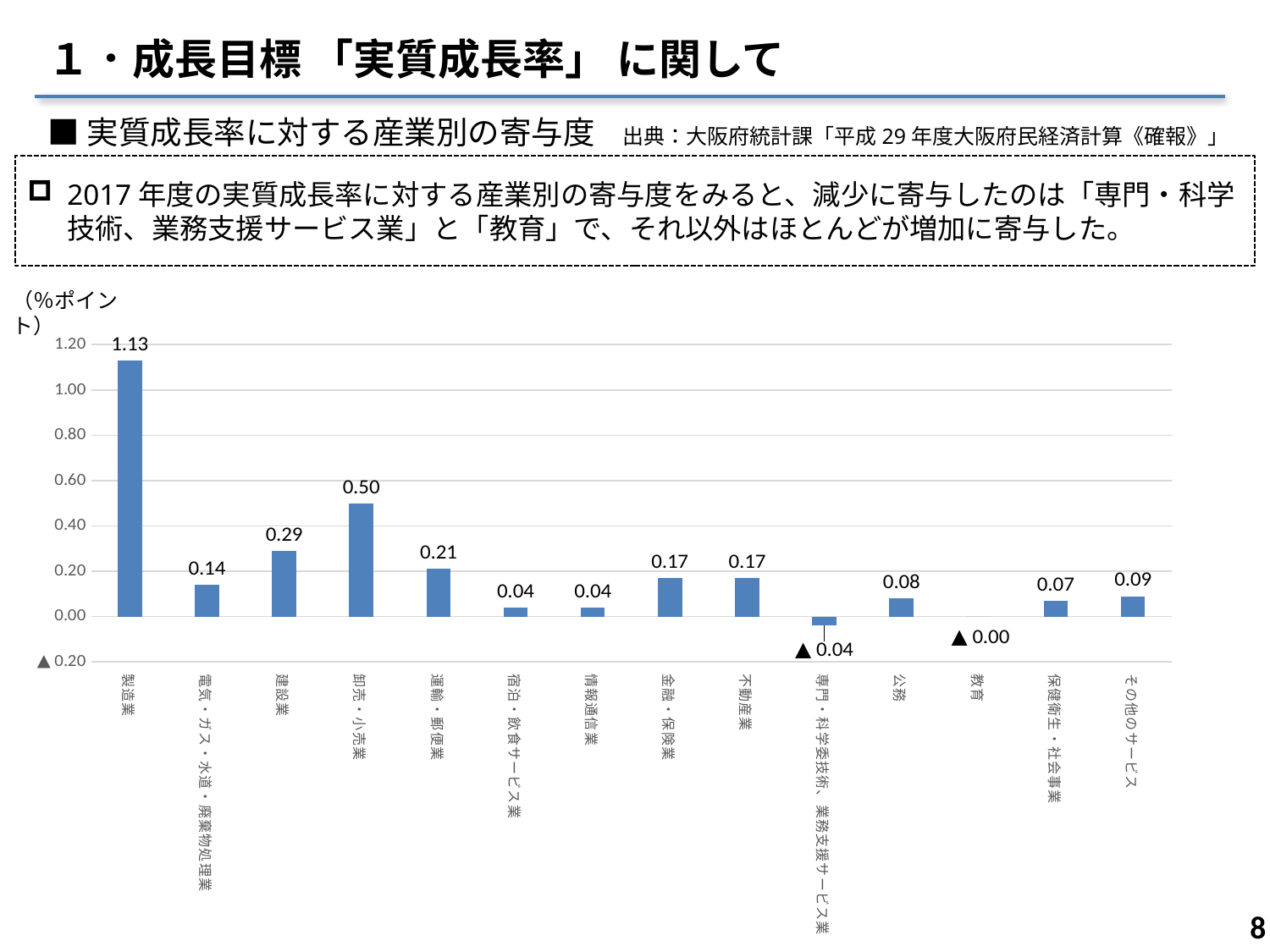
Which is larger, the value for 建設業 or the value for 運輸・郵便業? 建設業 What is the difference between the values for 公務 and その他のサービス? 0.01 What unit is shown above the vertical axis of the chart? %ポイント What kind of chart is shown on the slide? bar chart What is the value for 専門・科学委技術、業務支援サービス業? ▲ 0.04 What is the value for 保健衛生・社会事業? 0.07 What is the value for 卸売・小売業? 0.50 How many categories are shown on the x axis? 14 What is the value for 製造業? 1.13 What is the difference between the values for 製造業 and 卸売・小売業? 0.63 Which category has the lowest value? 専門・科学委技術、業務支援サービス業 Which category has the highest value? 製造業